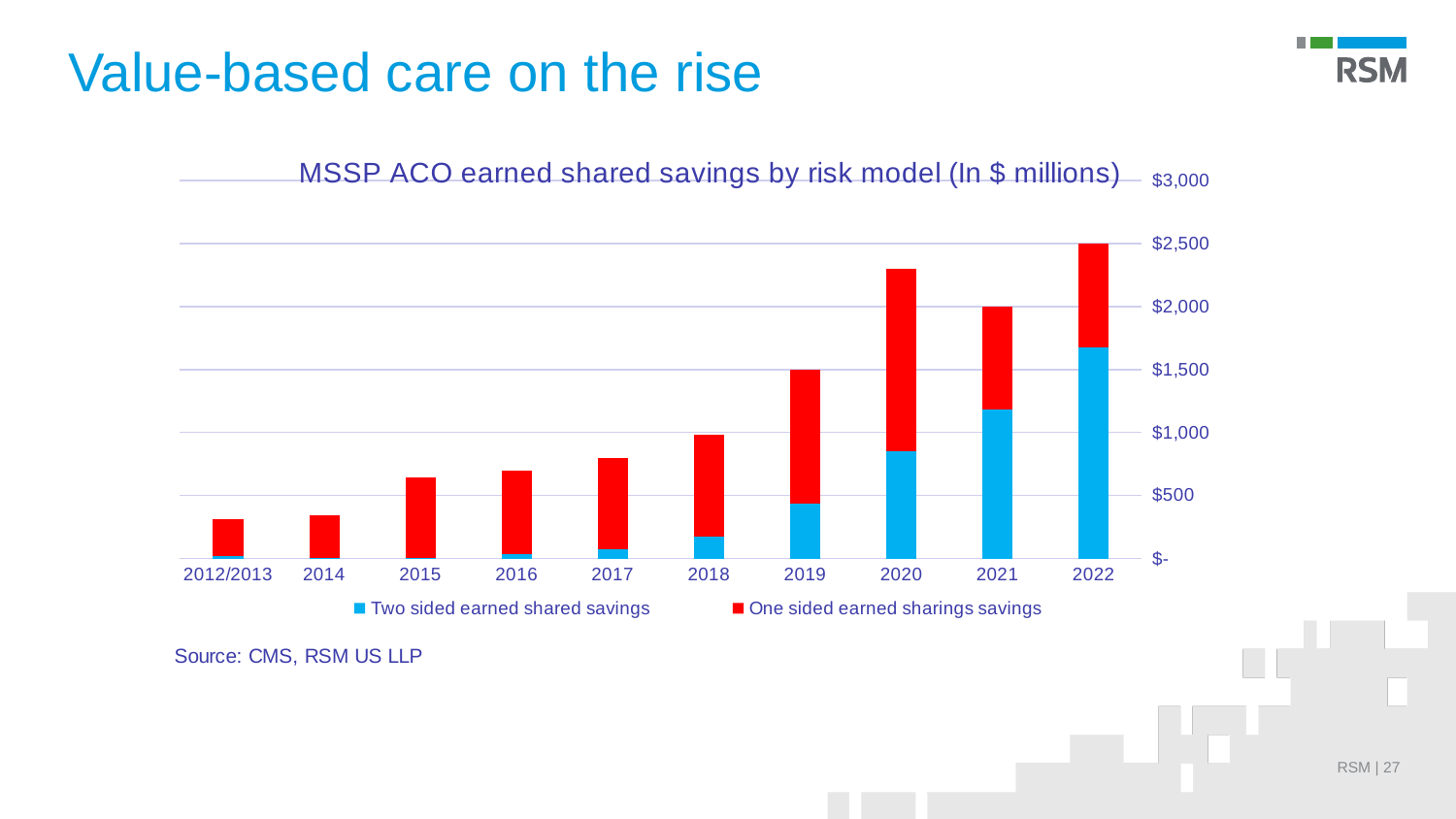
Which year has the larger total earned shared savings, 2020 or 2021? 2020 Which year has the lowest total earned shared savings? 2012/2013 Which colour represents one sided earned sharings savings in the chart? Red What kind of chart is shown on the slide? Stacked bar chart How many series does the chart's legend list? 2 How many year categories are shown on the x axis of the chart? 10 Is the total earned shared savings for 2020 greater or less than $2,000? greater Do total earned shared savings generally rise or fall from 2012/2013 to 2022? rise Is the two sided earned shared savings for 2022 greater or less than $1,500? greater Is the total earned shared savings for 2014 greater or less than $500? less Which year has the highest total earned shared savings? 2022